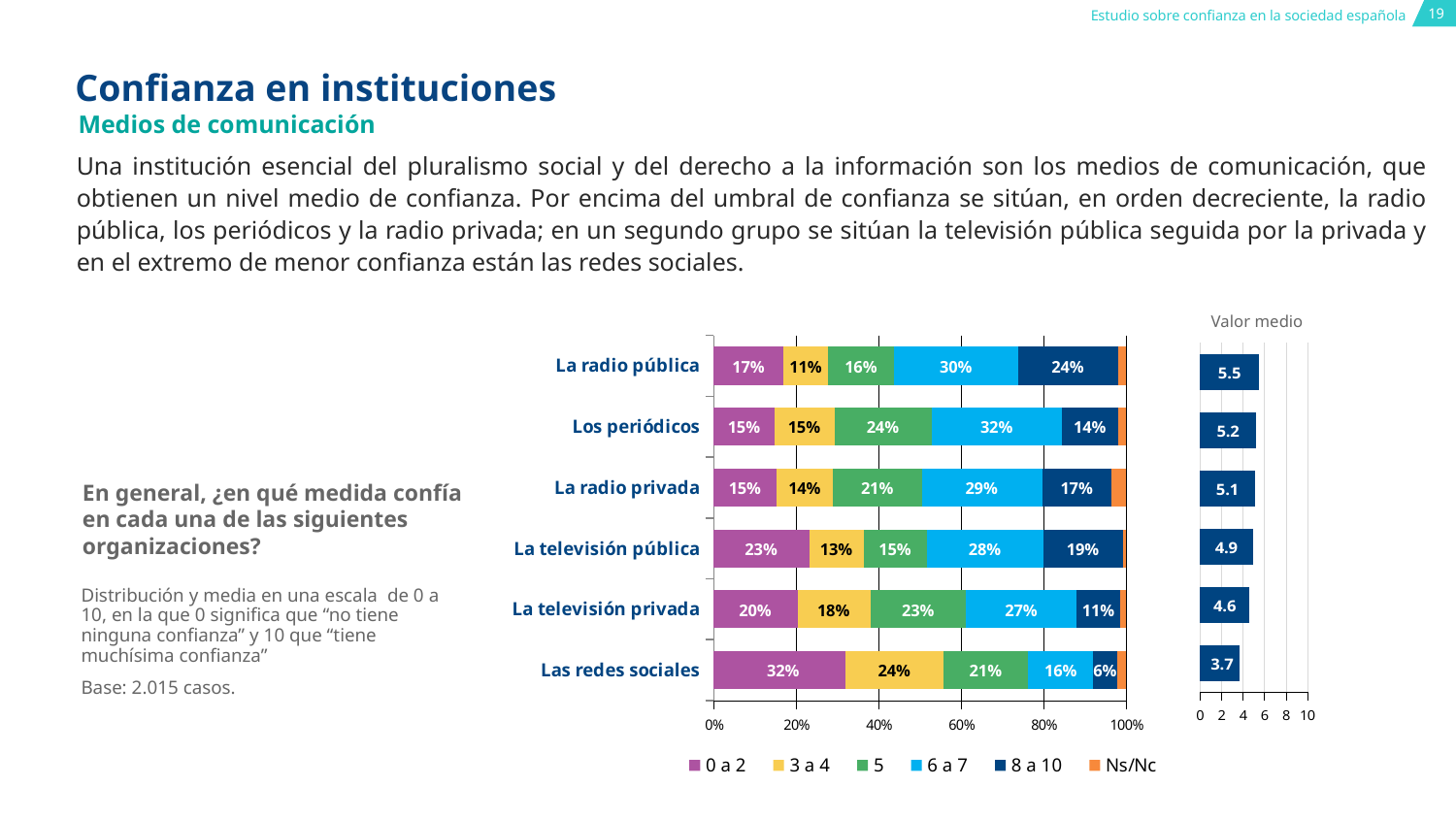
In the stacked bar chart, what percentage of respondents gave 'La radio pública' a score of 8 a 10? 24% In the stacked bar chart, which has a larger share of 6 a 7 scores: 'Los periódicos' or 'La radio privada'? Los periódicos In the stacked bar chart, what percentage of respondents gave 'La televisión privada' a score of 3 a 4? 18% In the 'Valor medio' chart, what is the mean value for 'Los periódicos'? 5.2 In the 'Valor medio' chart, which institution has the highest mean value? La radio pública In the 'Valor medio' chart, what is the difference between the mean value for 'La radio pública' and 'Las redes sociales'? 1.8 How many series does the legend of the stacked bar chart list? 6 What type of chart is used to show the distribution of confidence scores by institution? Stacked bar chart In the stacked bar chart, what percentage of respondents gave 'Las redes sociales' a score of 0 a 2? 32% In the stacked bar chart, how many institutions are listed? 6 In the stacked bar chart, how much larger is the 0 a 2 share for 'Las redes sociales' than for 'La radio pública'? 15% In the 'Valor medio' chart, which institution has the lowest mean value? Las redes sociales